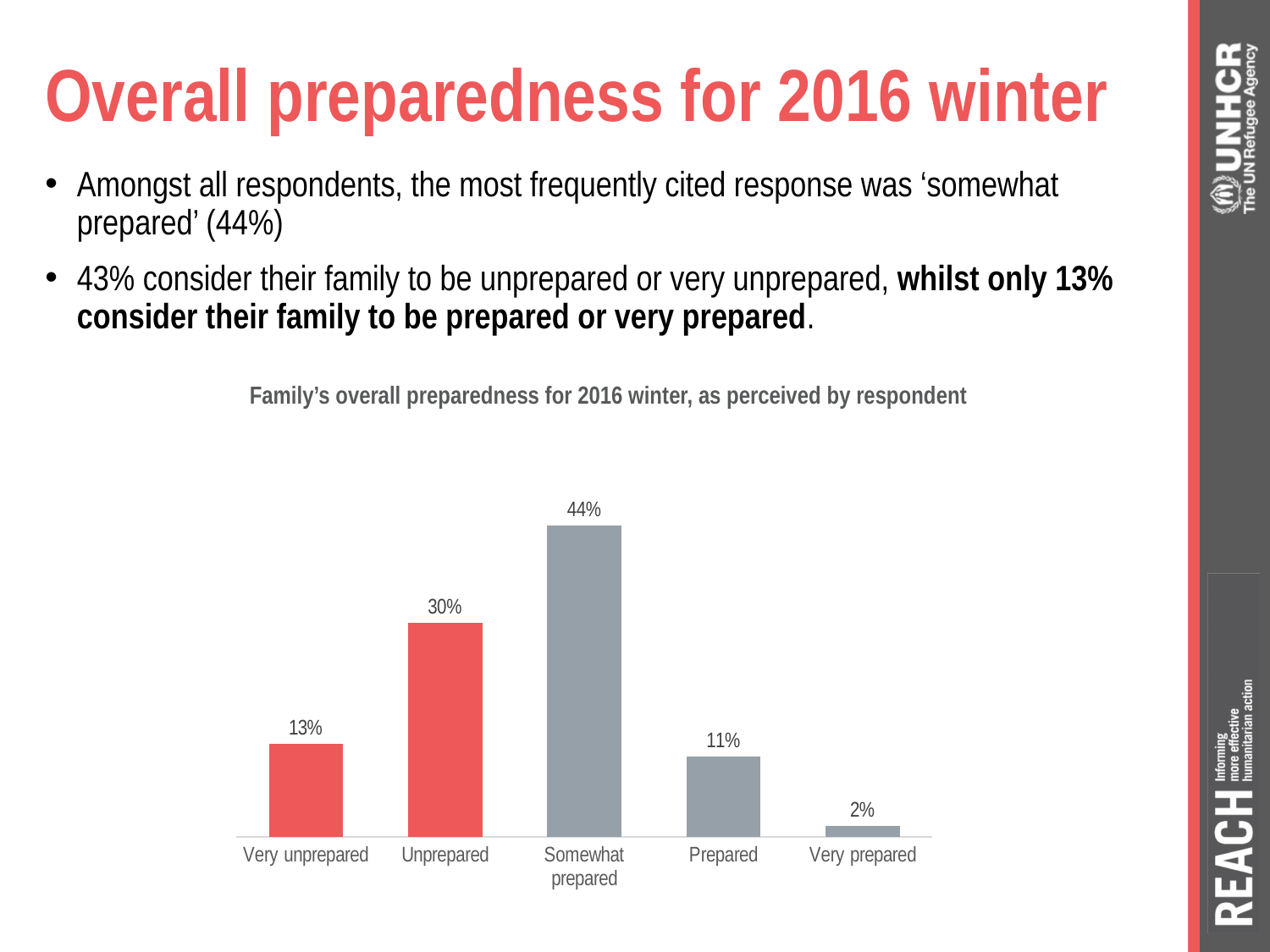
What is the title of the chart? Family's overall preparedness for 2016 winter, as perceived by respondent Which is larger, the value for 'Very unprepared' or the value for 'Prepared'? Very unprepared How many categories are shown on the x axis? 5 What is the value for 'Somewhat prepared'? 44% What is the value for 'Very unprepared'? 13% Which category has the lowest value? Very prepared What is the difference between the values for 'Unprepared' and 'Prepared'? 19% Which categories are shown with red bars? Very unprepared and Unprepared What is the value for 'Very prepared'? 2% What kind of chart is shown on the slide? Bar chart What is the combined value of 'Prepared' and 'Very prepared'? 13% Which category has the highest value? Somewhat prepared